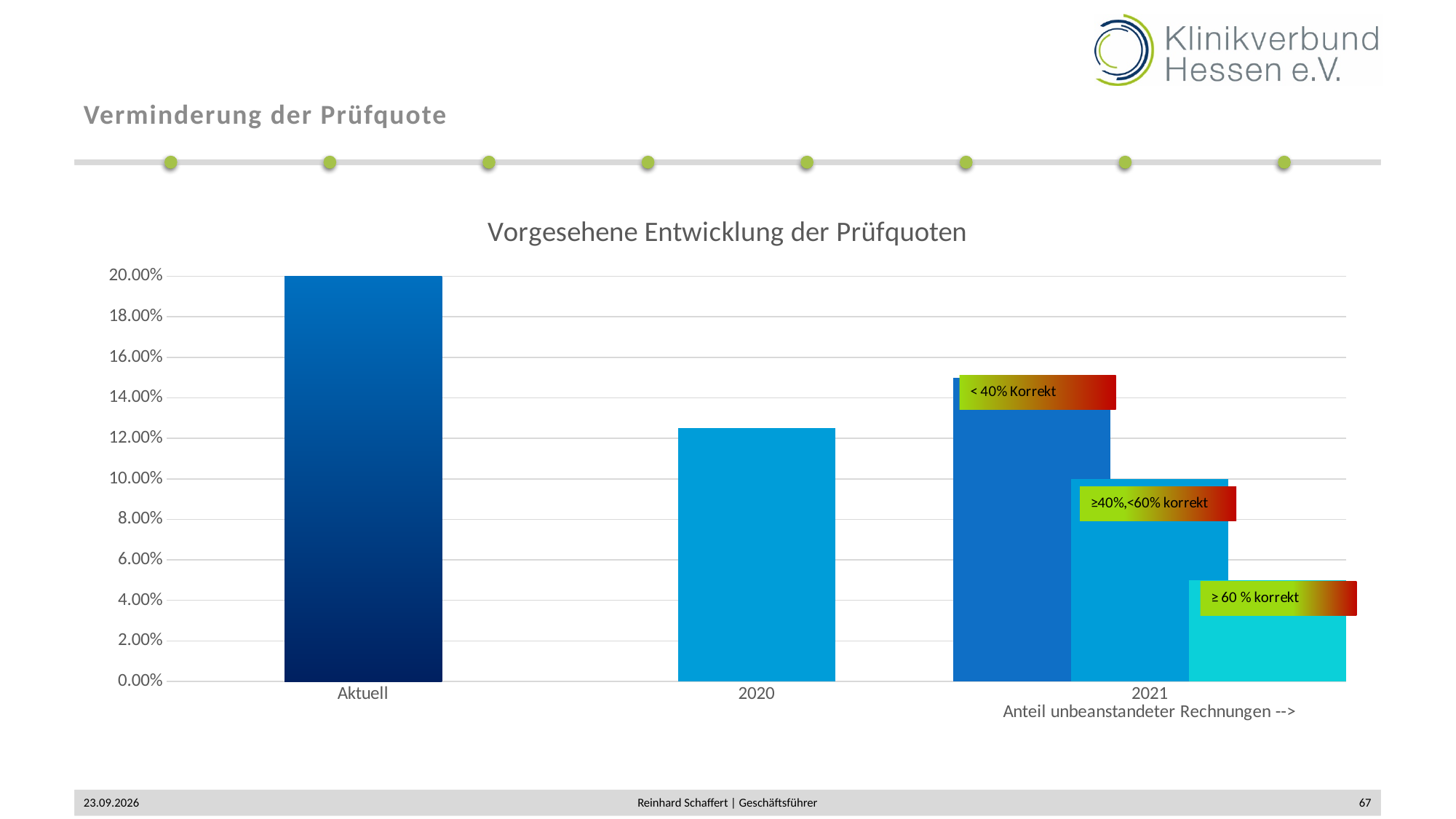
What is the value of the bar for Aktuell? 20.00% Is the value for 2020 greater or less than 12.00%? greater How many categories are shown on the x axis? 3 Which category has the highest bar? Aktuell What is the title of the chart? Vorgesehene Entwicklung der Prüfquoten In 2021, what is the value of the bar labelled '≥40%,<60% korrekt'? 10.00% Which is larger, the bar for Aktuell or the bar for 2020? Aktuell In 2021, is the bar labelled '< 40% Korrekt' greater or less than 14.00%? greater In 2021, is the bar labelled '≥ 60 % korrekt' greater or less than 6.00%? less Do the bar heights rise or fall from Aktuell to 2021? fall What kind of chart is shown on the slide? bar chart